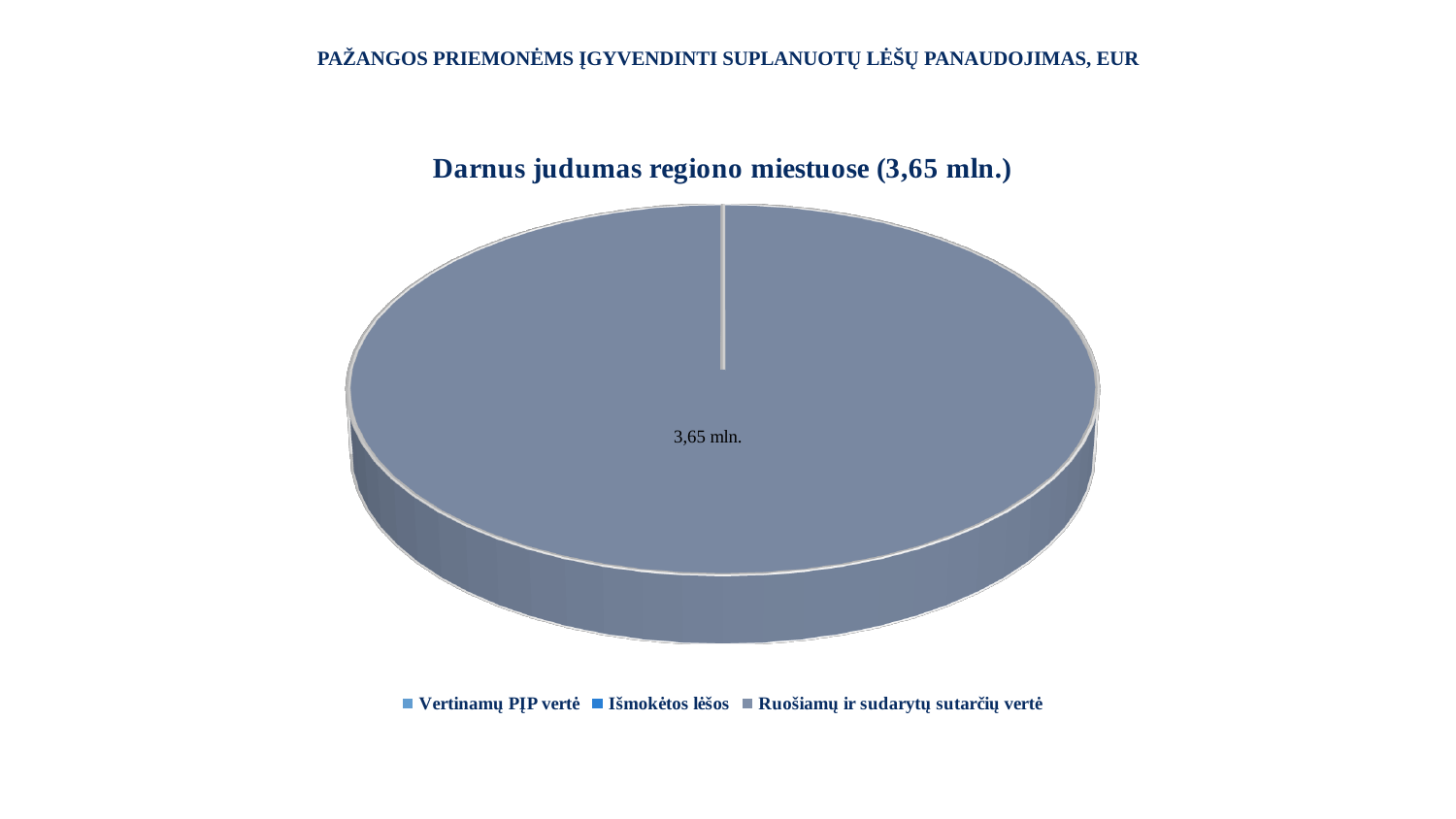
What value is printed as the data label on the pie? 3,65 mln. How many visible slices does the pie chart have? 1 Which legend entry does the colour of the visible pie slice correspond to? Ruošiamų ir sudarytų sutarčių vertė What share of the pie does the single visible slice occupy? 100% What total value is given in parentheses in the chart title? 3,65 mln. What is the title of the chart? Darnus judumas regiono miestuose (3,65 mln.) What kind of chart is shown on the slide? pie chart What is the value for Ruošiamų ir sudarytų sutarčių vertė? 3,65 mln. How many entries does the chart legend list? 3 What is the heading text at the top of the slide? PAŽANGOS PRIEMONĖMS ĮGYVENDINTI SUPLANUOTŲ LĖŠŲ PANAUDOJIMAS, EUR